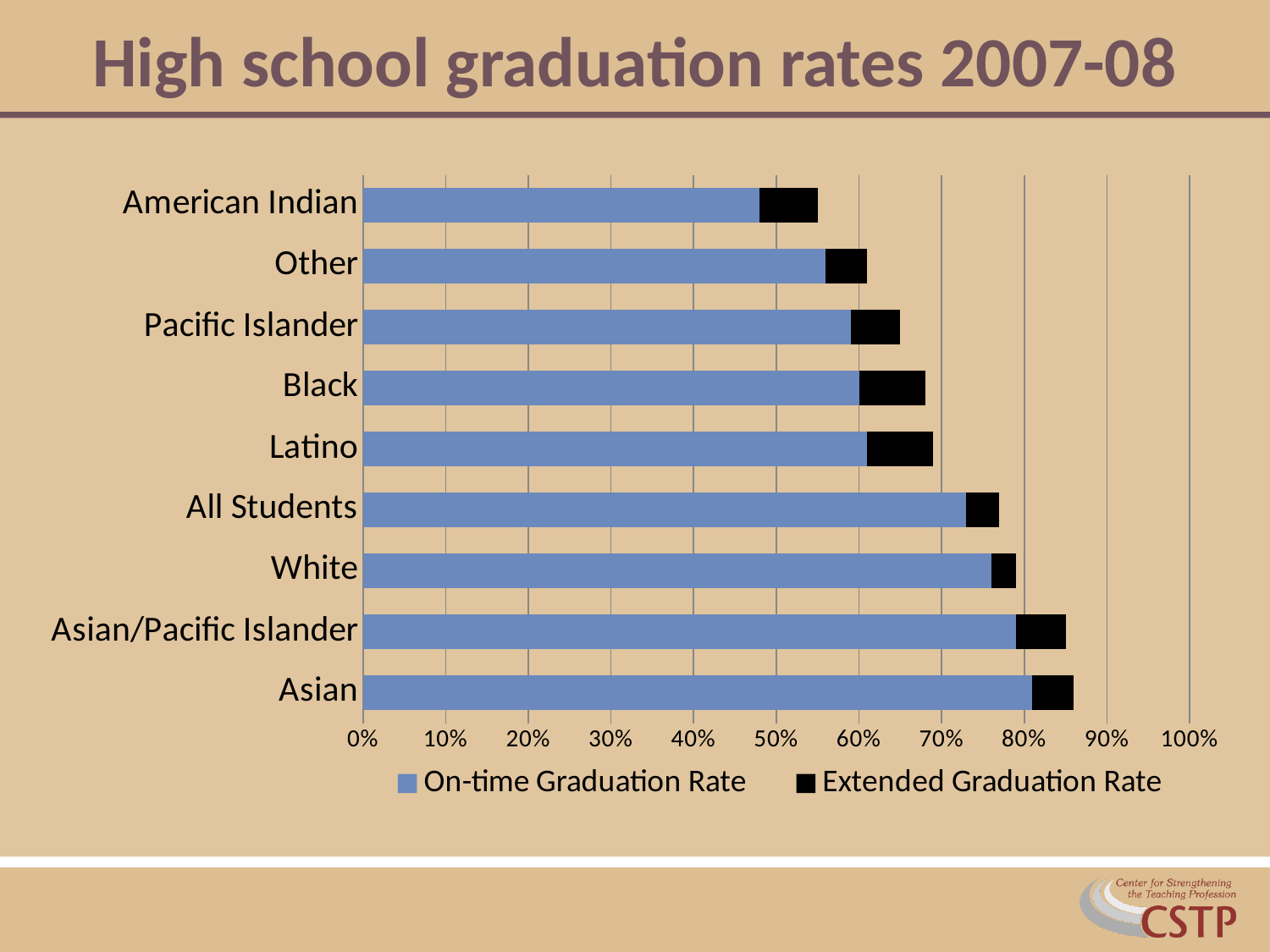
How many student groups are listed on the chart? 9 Which has a higher On-time Graduation Rate, White or Black? White How many series does the legend list? 2 What kind of chart is shown on the slide? Stacked bar chart What is the title of the chart? High school graduation rates 2007-08 Is the On-time Graduation Rate for All Students greater or less than 70%? greater Is the On-time Graduation Rate for White students greater or less than 70%? greater Which group has the lowest On-time Graduation Rate? American Indian Is the On-time Graduation Rate for American Indian students greater or less than 50%? less Which has a higher On-time Graduation Rate, Asian or American Indian? Asian